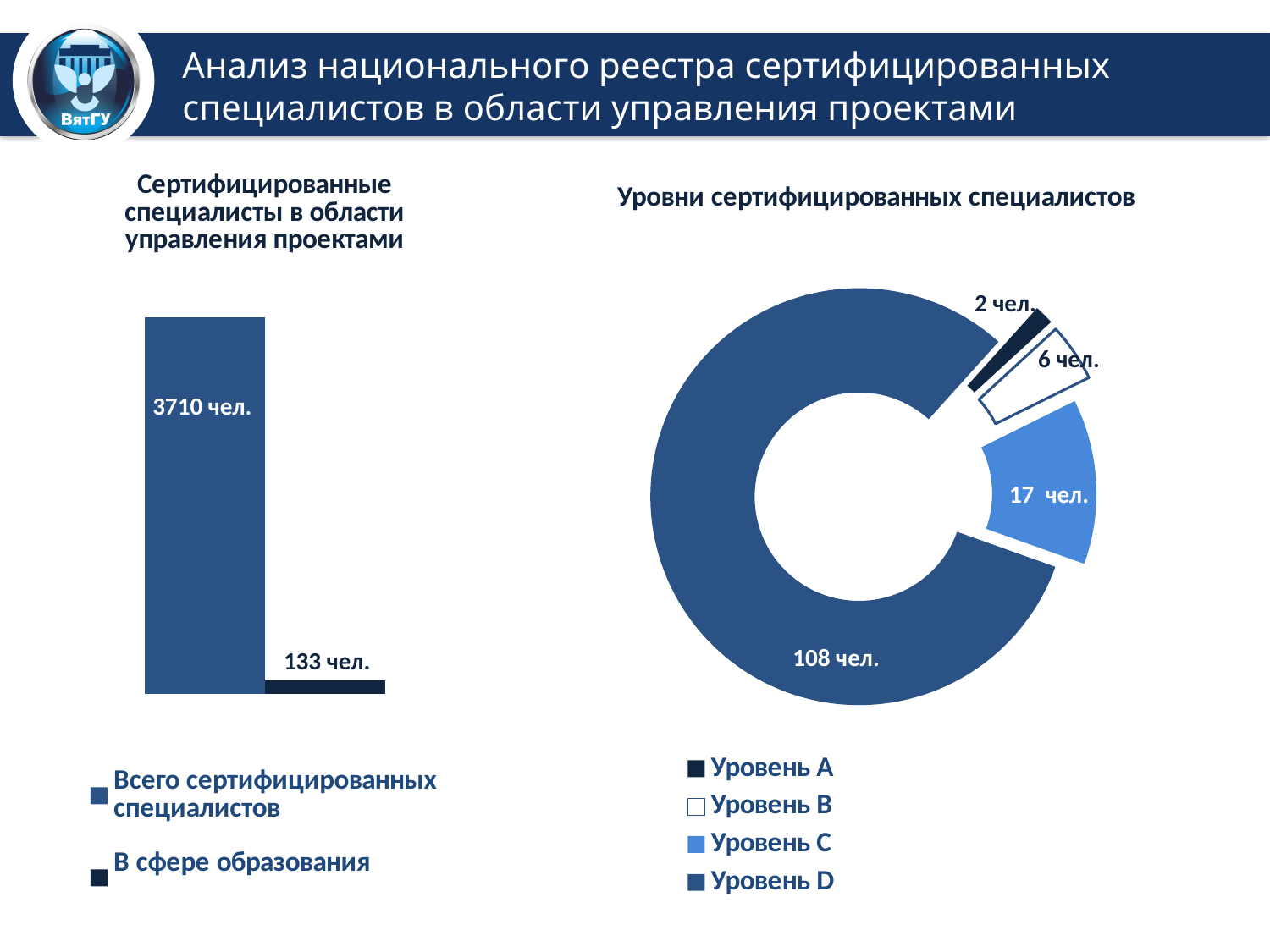
How many categories does the right chart 'Уровни сертифицированных специалистов' show? 4 In the right chart 'Уровни сертифицированных специалистов', what is the difference between 'Уровень D' and 'Уровень C'? 91 чел. In the right chart 'Уровни сертифицированных специалистов', what is the value for 'Уровень A'? 2 чел. In the right chart 'Уровни сертифицированных специалистов', which level has the highest value? Уровень D In the right chart 'Уровни сертифицированных специалистов', what is the value for 'Уровень C'? 17 чел. In the left chart 'Сертифицированные специалисты в области управления проектами', what is the value for 'В сфере образования'? 133 чел. What kind of chart is the left chart 'Сертифицированные специалисты в области управления проектами'? Bar chart In the left chart 'Сертифицированные специалисты в области управления проектами', what is the difference between 'Всего сертифицированных специалистов' and 'В сфере образования'? 3577 чел. How many series does the legend of the left chart 'Сертифицированные специалисты в области управления проектами' list? 2 In the right chart 'Уровни сертифицированных специалистов', which level has the lowest value? Уровень A In the right chart 'Уровни сертифицированных специалистов', which is larger: 'Уровень B' or 'Уровень C'? Уровень C In the left chart 'Сертифицированные специалисты в области управления проектами', what is the value for 'Всего сертифицированных специалистов'? 3710 чел.